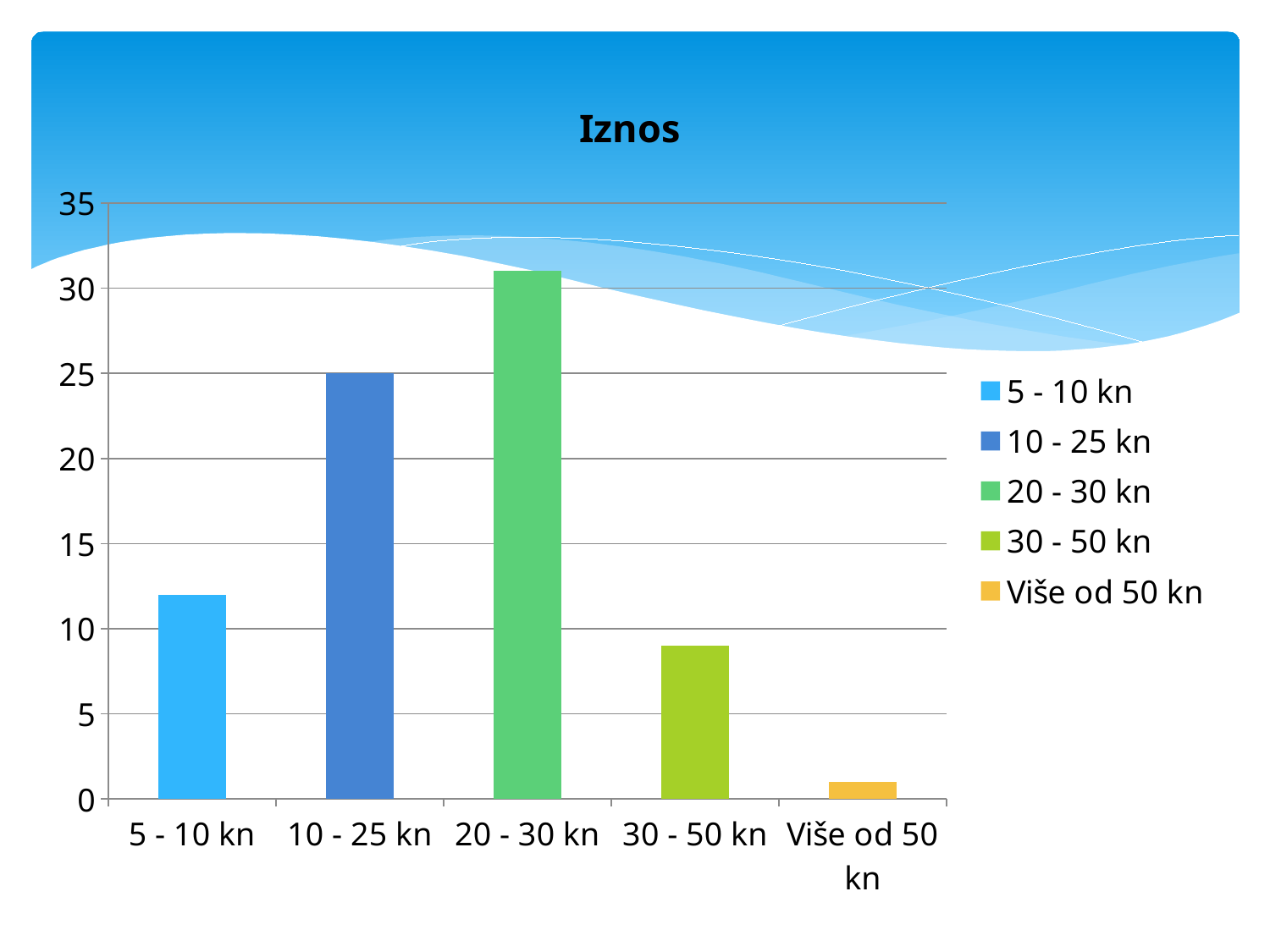
Which is larger, the value for 5 - 10 kn or the value for 30 - 50 kn? 5 - 10 kn What is the title of the chart? Iznos Which category has the lowest value? Više od 50 kn Which category has the highest value? 20 - 30 kn What type of chart is shown on the slide? bar chart Is the value for 20 - 30 kn greater or less than 30? greater How many categories are shown on the x axis of the chart? 5 Is the value for 30 - 50 kn greater or less than 10? less Which is larger, the value for 10 - 25 kn or the value for 20 - 30 kn? 20 - 30 kn Is the value for 5 - 10 kn greater or less than 10? greater How many entries does the legend list? 5 What is the value for 10 - 25 kn? 25